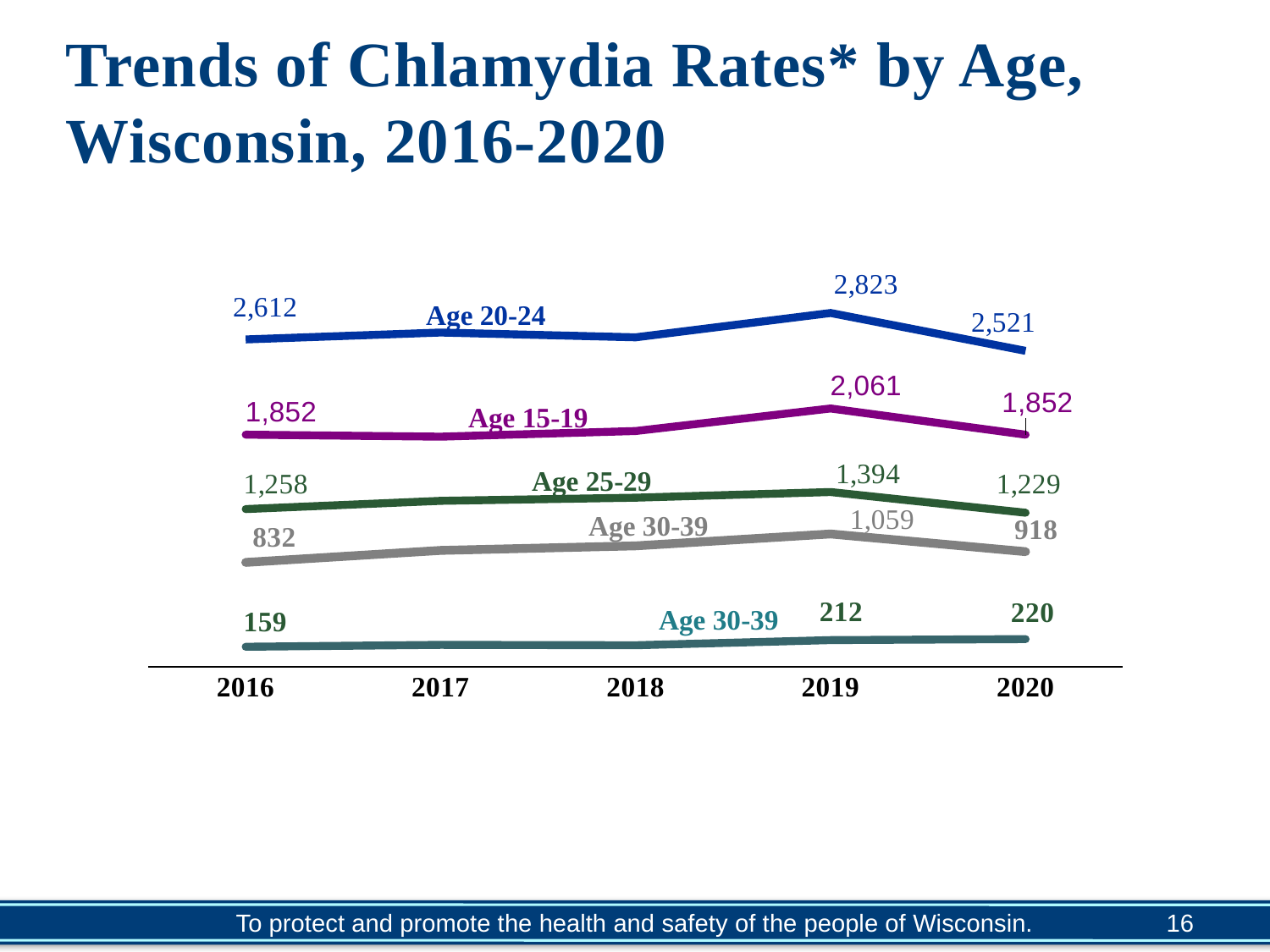
How many years are shown on the x axis? 5 What type of chart is shown on the slide? line chart What was the chlamydia rate for Age 25-29 in 2020? 1,229 What was the chlamydia rate for the gray Age 30-39 line in 2019? 1,059 By how much did the Age 20-24 rate change from 2019 to 2020? 302 What value is labeled for the lowest (bottom) line in 2020? 220 Which was higher in 2020, the Age 25-29 rate or the gray Age 30-39 rate? Age 25-29 Did the Age 20-24 rate rise or fall from 2019 to 2020? fall What is the difference between the Age 15-19 and Age 25-29 rates in 2019? 667 What was the chlamydia rate for Age 15-19 in 2016? 1,852 What was the chlamydia rate for Age 20-24 in 2019? 2,823 Which age group had the highest chlamydia rate in 2019? Age 20-24